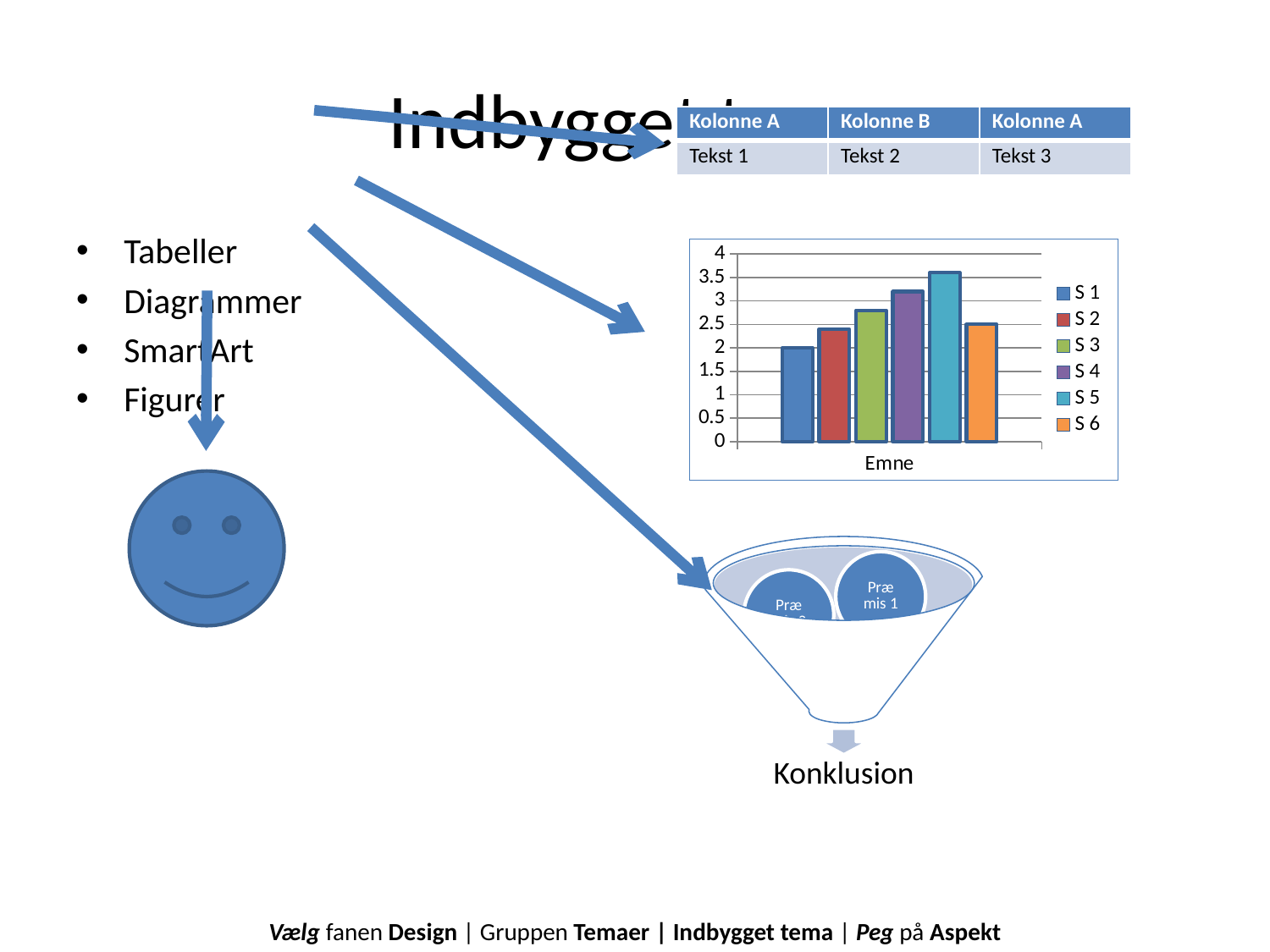
How many series does the chart's legend list? 6 Which is larger in the chart, the S 4 bar or the S 2 bar? S 4 How many categories are shown on the chart's x axis? 1 Which series has the lowest bar in the chart? S 1 Is the value for S 4 greater or less than 3? greater What is the value of the S 6 bar in the chart? 2.5 What kind of chart is shown on the slide? bar chart What is the value of the S 1 bar in the chart? 2 What is the difference between the S 6 bar and the S 1 bar? 0.5 Which series has the highest bar in the chart? S 5 Is the value for S 2 greater or less than 2? greater Is the value for S 3 greater or less than 3? less